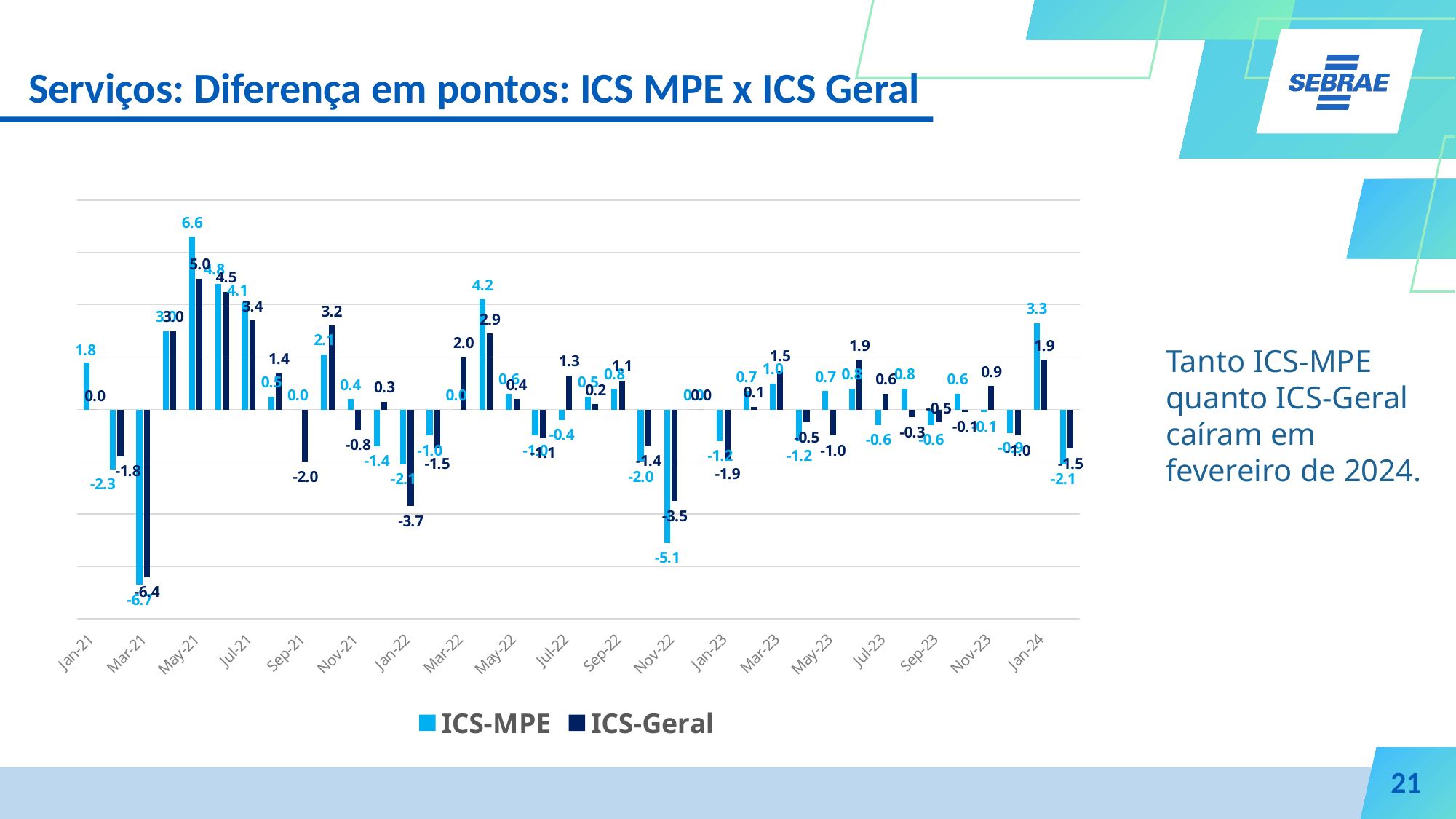
What are the two series named in the legend? ICS-MPE and ICS-Geral What is the difference between the ICS-MPE and ICS-Geral values in Jan-24? 1.4 In Jan-24, which series has the larger value, ICS-MPE or ICS-Geral? ICS-MPE In which month does ICS-MPE reach its highest value? May-21 How many series does the legend list? 2 What is the ICS-MPE value for Nov-22? -5.1 What is the difference between the ICS-MPE and ICS-Geral values in May-21? 1.6 What kind of chart is shown on the slide? bar chart What is the ICS-MPE value for May-21? 6.6 In which month does ICS-MPE reach its lowest value? Mar-21 What is the ICS-Geral value for Nov-22? -3.5 What is the ICS-Geral value for Jan-24? 1.9